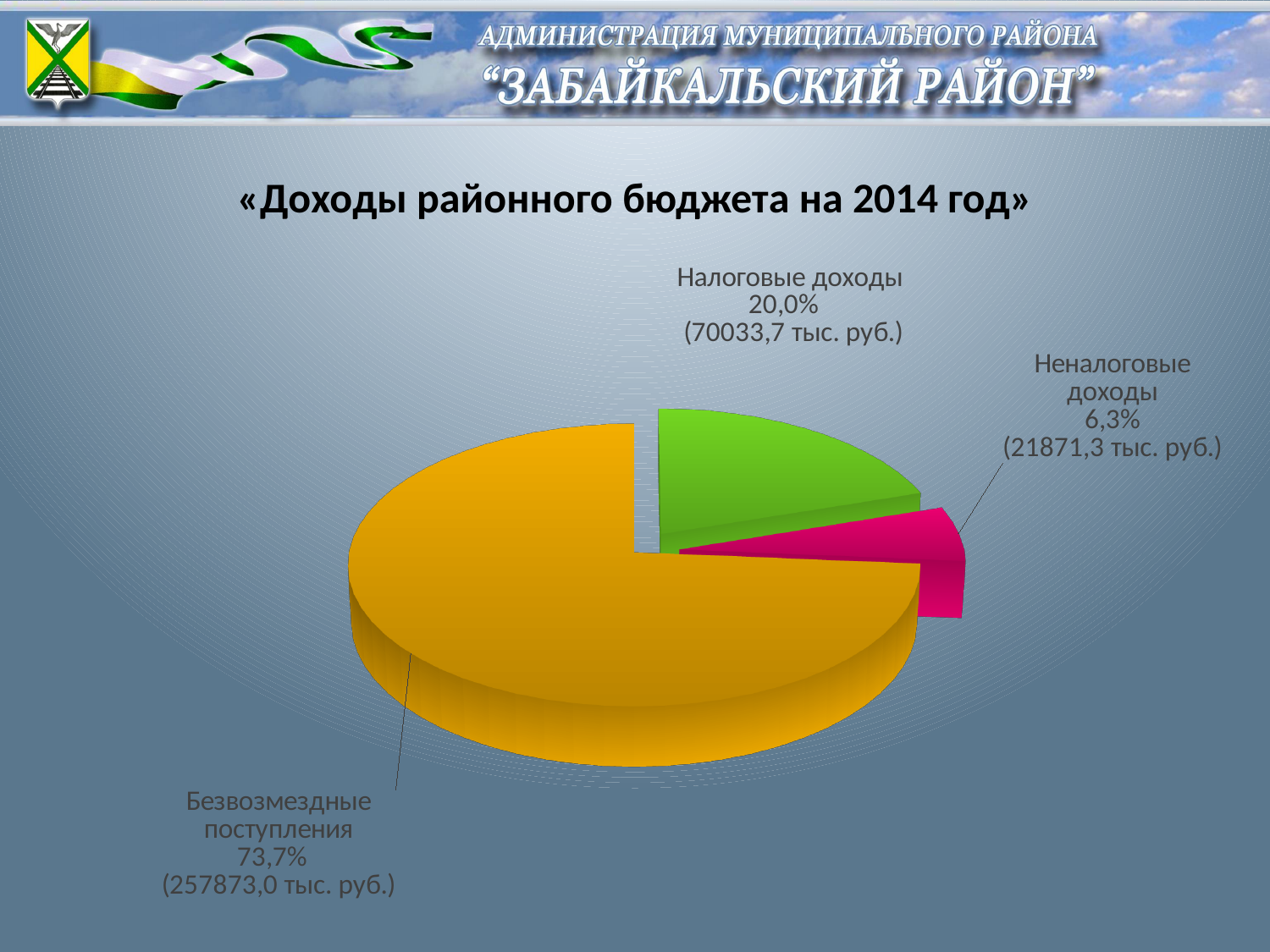
What share of the pie is Безвозмездные поступления? 73,7% What is the value in тыс. руб. for Неналоговые доходы? 21871,3 тыс. руб. What is the value in тыс. руб. for Налоговые доходы? 70033,7 тыс. руб. What share of the pie is Неналоговые доходы? 6,3% Which category has the largest share of the pie? Безвозмездные поступления What share of the pie is Налоговые доходы? 20,0% What is the title of the chart? «Доходы районного бюджета на 2014 год» What kind of chart is shown on the slide? pie chart Which is larger, Налоговые доходы or Неналоговые доходы? Налоговые доходы Which category has the smallest share of the pie? Неналоговые доходы How many slices does the pie chart have? 3 What is the value in тыс. руб. for Безвозмездные поступления? 257873,0 тыс. руб.